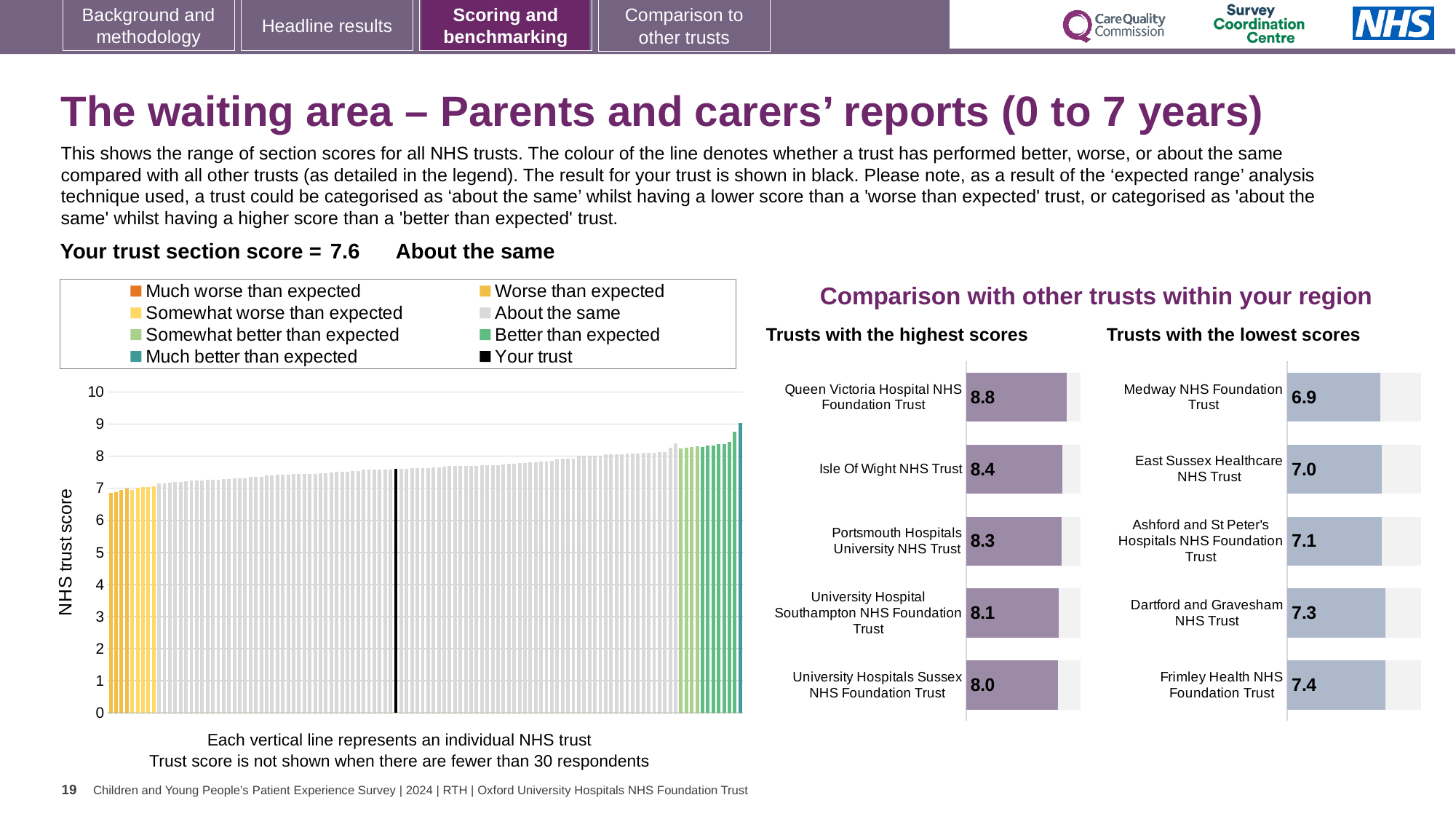
In the 'Trusts with the highest scores' chart, which trust has the lowest score? University Hospitals Sussex NHS Foundation Trust In the 'Trusts with the lowest scores' chart, what is the difference between the scores of Frimley Health NHS Foundation Trust and Medway NHS Foundation Trust? 0.5 How many entries does the legend of the large chart on the left list? 8 In the 'Trusts with the lowest scores' chart, which trust has the highest score? Frimley Health NHS Foundation Trust In the 'Trusts with the lowest scores' chart, which has the larger score: Dartford and Gravesham NHS Trust or East Sussex Healthcare NHS Trust? Dartford and Gravesham NHS Trust How many trusts are shown in the 'Trusts with the lowest scores' chart? 5 In the 'Trusts with the highest scores' chart, what is the score for Portsmouth Hospitals University NHS Trust? 8.3 In the 'Trusts with the highest scores' chart, what is the score for Queen Victoria Hospital NHS Foundation Trust? 8.8 What kind of chart is the large chart on the left showing NHS trust scores? Bar chart In the 'Trusts with the highest scores' chart, what is the difference between the scores of Queen Victoria Hospital NHS Foundation Trust and University Hospitals Sussex NHS Foundation Trust? 0.8 In the 'Trusts with the lowest scores' chart, what is the score for Medway NHS Foundation Trust? 6.9 In the large chart on the left, do the trust scores rise or fall from left to right? Rise